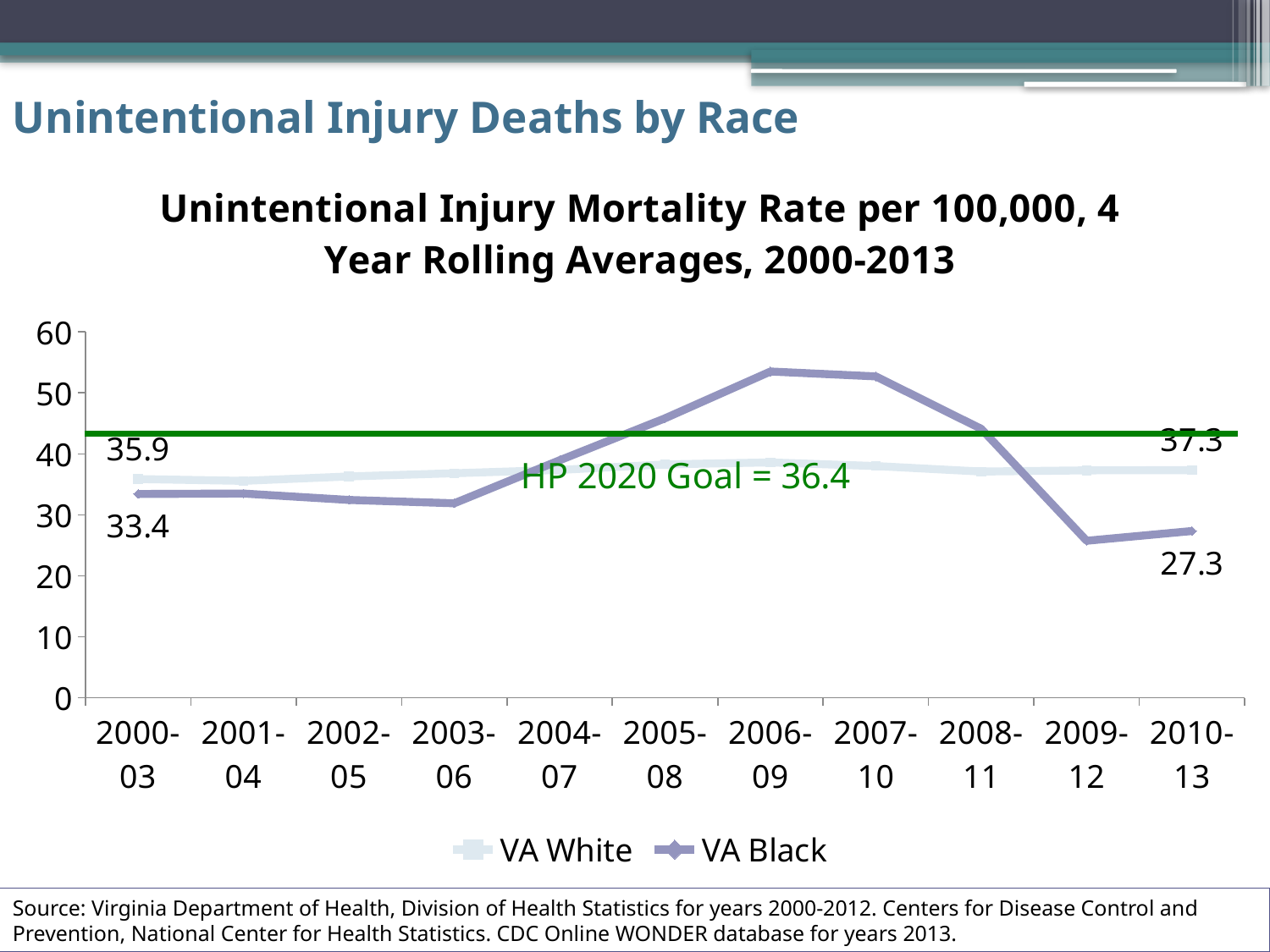
Which series has the higher value in 2010-13, VA White or VA Black? VA White By how much did the VA Black value change from 2000-03 to 2010-13? 6.1 lower What is the difference between the VA White and VA Black values for 2010-13? 10 What kind of chart is shown on the slide? Line chart What is the VA Black value for 2010-13? 27.3 What is the HP 2020 Goal shown on the chart? 36.4 What is the VA Black value for 2000-03? 33.4 Is the VA Black value for 2006-09 greater or less than 50? greater How many time periods are shown on the x axis? 11 What is the VA White value for 2010-13? 37.3 How many series does the legend list? 2 What is the VA White value for 2000-03? 35.9